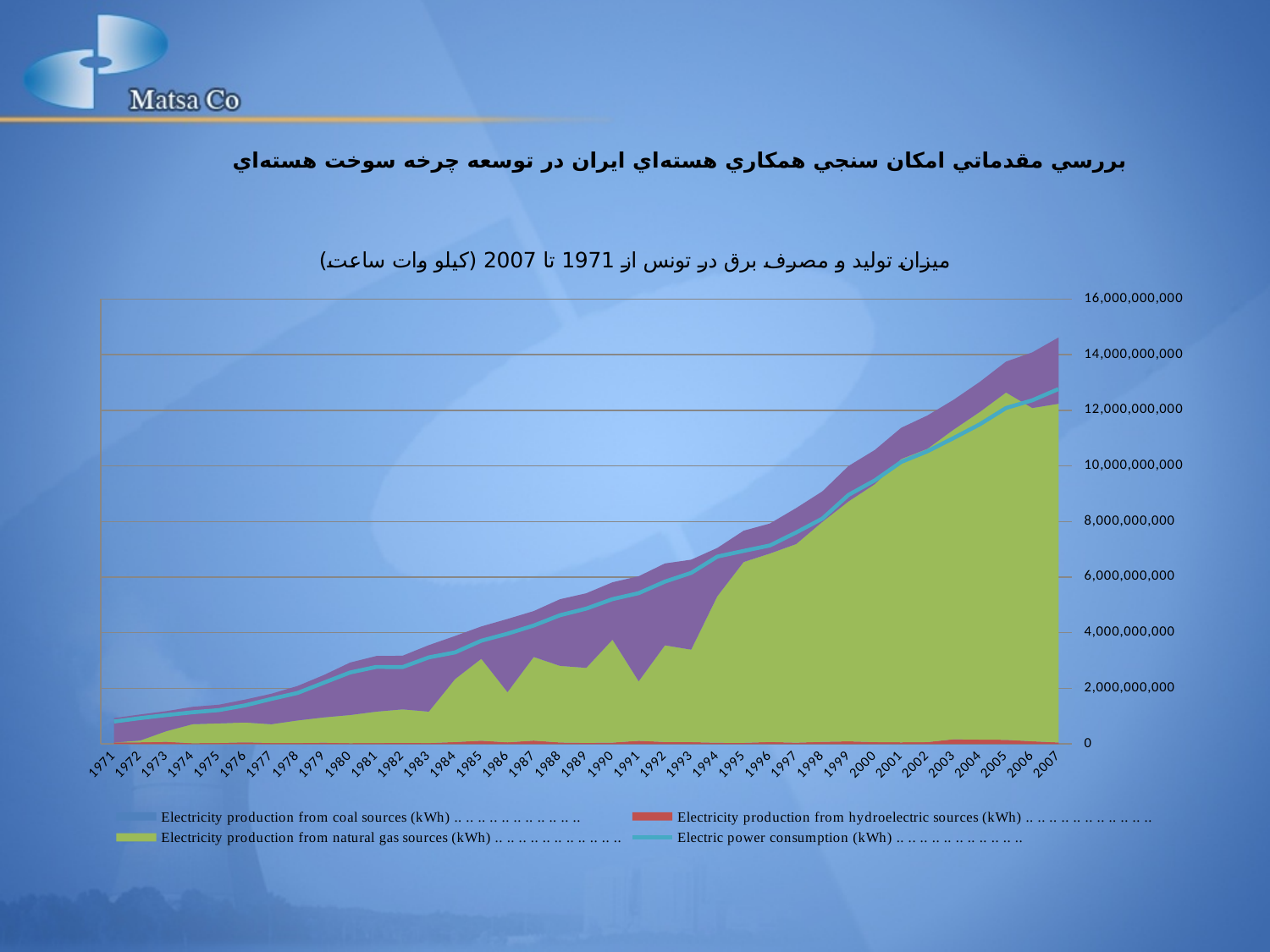
Is the value for Electric power consumption (kWh) in 1990 greater or less than 8,000,000,000? less In which year is Electric power consumption (kWh) lowest? 1971 How many series does the chart legend list? 4 How many years are plotted along the x axis of the chart? 37 What is the first year shown on the x axis? 1971 In which year is Electric power consumption (kWh) highest? 2007 Is the value for Electric power consumption (kWh) in 2007 greater or less than 10,000,000,000? greater Does Electric power consumption (kWh) rise or fall from 1971 to 2007? Rise Is Electric power consumption (kWh) larger in 2000 or in 1980? 2000 Is the value for Electric power consumption (kWh) in 1971 greater or less than 2,000,000,000? less What kind of chart is shown on the slide? Area chart What is the highest value shown on the y axis? 16,000,000,000